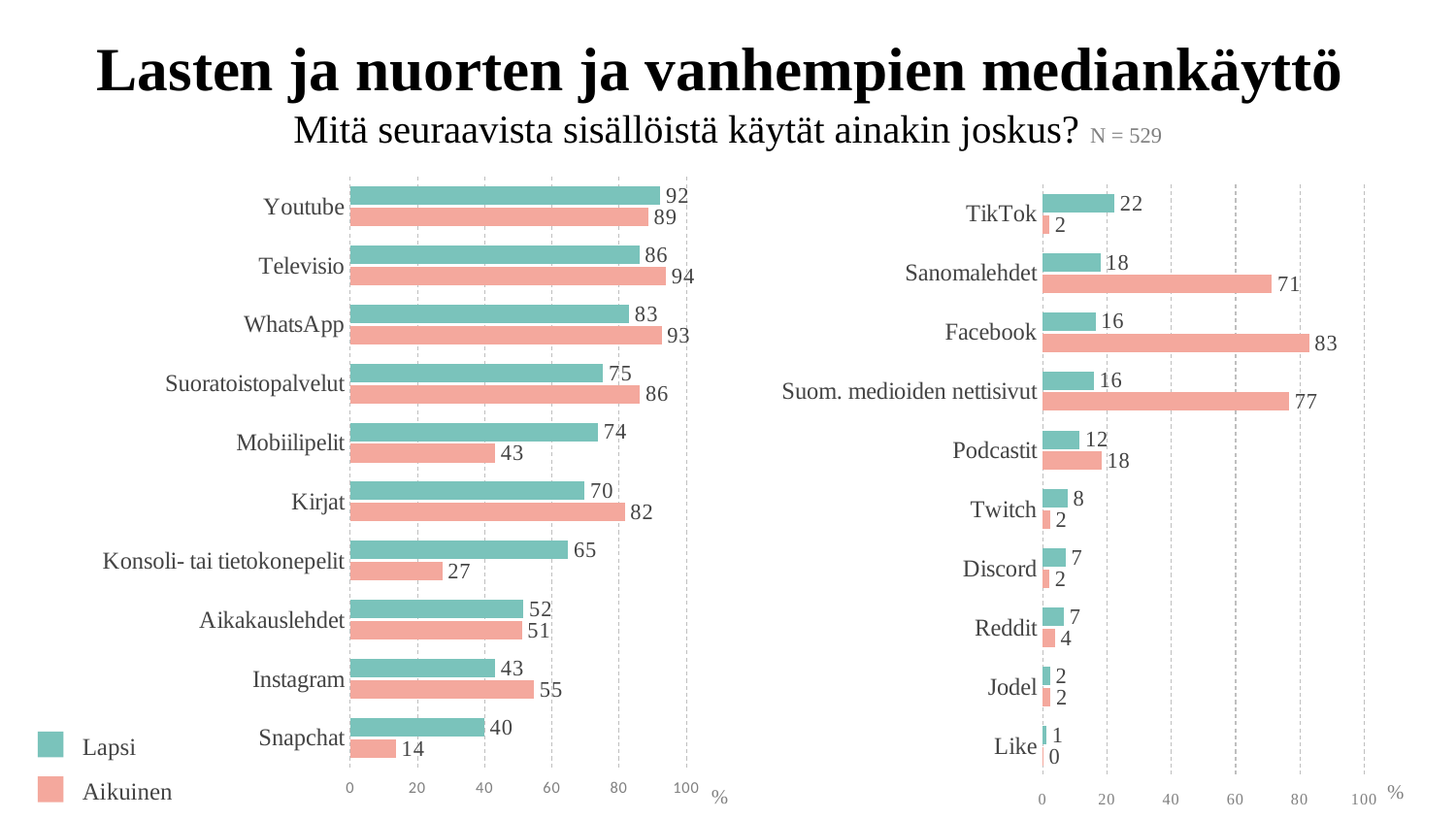
What type of chart is the left chart? Bar chart In the right chart, which is larger for Sanomalehdet, the Lapsi value or the Aikuinen value? Aikuinen In the right chart, which category has the lowest Aikuinen value? Like In the right chart, what is the Lapsi value for TikTok? 22 In the left chart, which category has the highest Lapsi value? Youtube In the left chart, what is the Aikuinen value for Televisio? 94 In the left chart, what is the difference between the Lapsi and Aikuinen values for Mobiilipelit? 31 How many series does the legend list? 2 In the right chart, what is the Aikuinen value for Facebook? 83 How many categories are shown in the right chart? 10 In the left chart, what is the Lapsi value for Youtube? 92 In the right chart, what is the difference between the Aikuinen and Lapsi values for Suom. medioiden nettisivut? 61